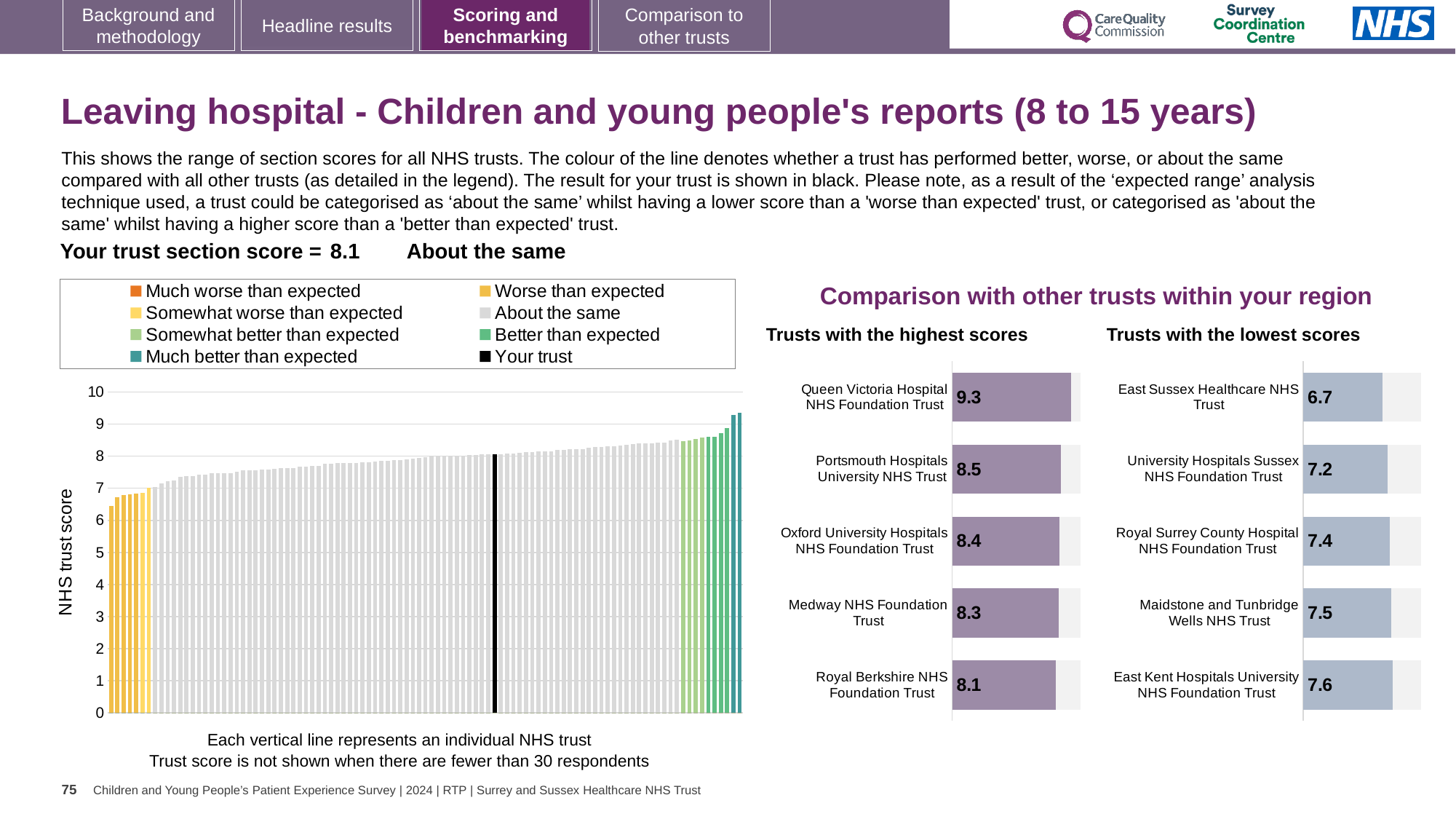
In the 'Trusts with the highest scores' chart, what is the score for Medway NHS Foundation Trust? 8.3 In the 'Trusts with the lowest scores' chart, what is the score for Royal Surrey County Hospital NHS Foundation Trust? 7.4 How many entries does the legend of the main chart showing the range of section scores list? 8 In the 'Trusts with the highest scores' chart, what is the score for Queen Victoria Hospital NHS Foundation Trust? 9.3 In the 'Trusts with the highest scores' chart, which trust has the highest score? Queen Victoria Hospital NHS Foundation Trust In the 'Trusts with the lowest scores' chart, what is the difference between the scores of East Kent Hospitals University NHS Foundation Trust and East Sussex Healthcare NHS Trust? 0.9 In the 'Trusts with the highest scores' chart, what is the difference between the scores of Queen Victoria Hospital NHS Foundation Trust and Royal Berkshire NHS Foundation Trust? 1.2 In the 'Trusts with the lowest scores' chart, which has the higher score: University Hospitals Sussex NHS Foundation Trust or Maidstone and Tunbridge Wells NHS Trust? Maidstone and Tunbridge Wells NHS Trust In the 'Trusts with the lowest scores' chart, which trust has the lowest score? East Sussex Healthcare NHS Trust In the main chart showing the range of section scores for all NHS trusts, what is the section score for your trust? 8.1 How many trusts are listed in the 'Trusts with the highest scores' chart? 5 In the main chart showing the range of section scores for all NHS trusts, is the value of the lowest-scoring trust greater or less than 7? less